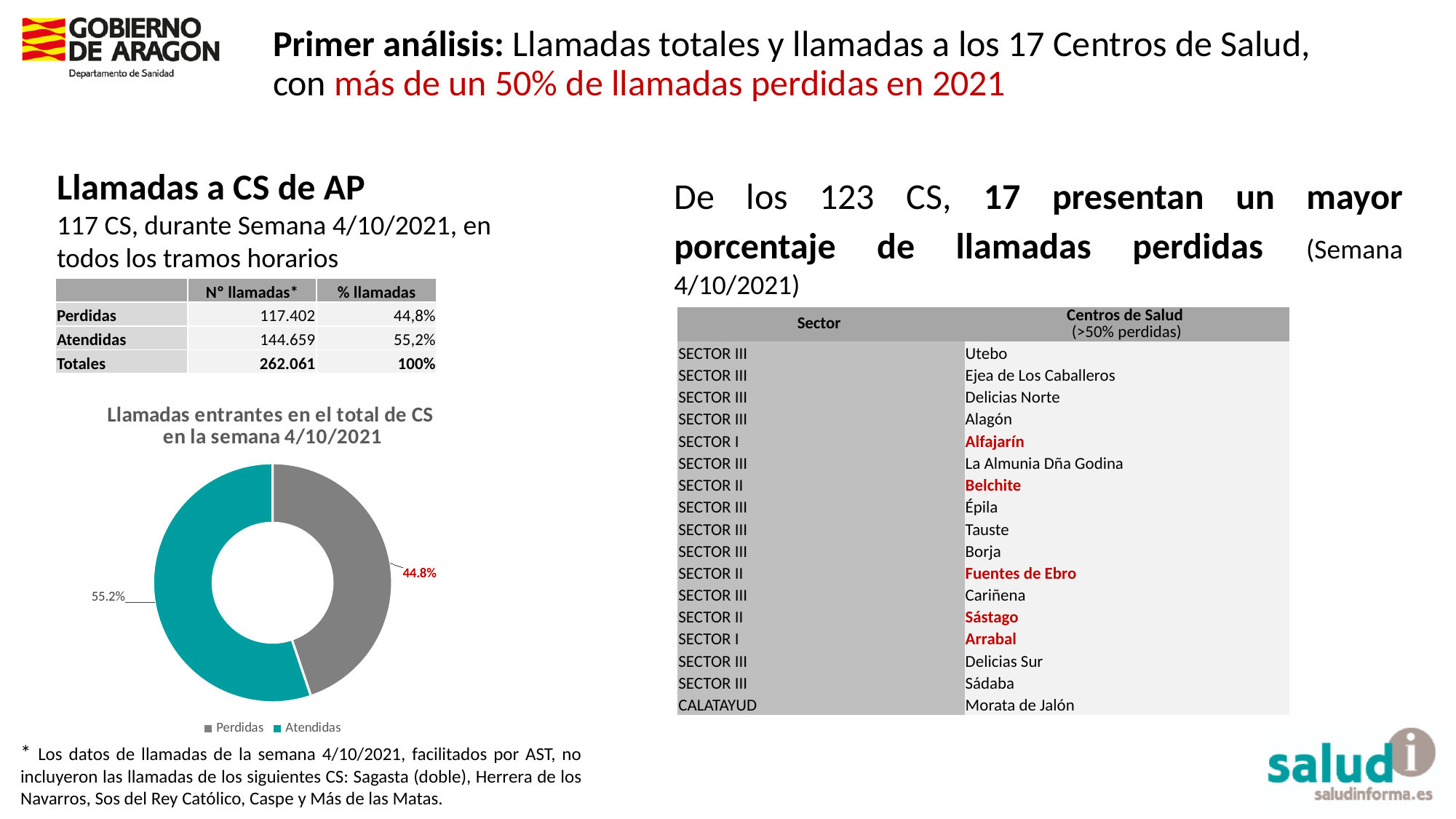
What colour is the Atendidas slice in the pie chart? teal What is the title of the chart? Llamadas entrantes en el total de CS en la semana 4/10/2021 What is the difference in percentage points between the Atendidas and Perdidas slices? 10.4 What do the two slices of the pie chart add up to? 100% What share of the pie chart does the Perdidas slice represent? 44.8% Which slice of the pie chart is the largest? Atendidas What share of the pie chart does the Atendidas slice represent? 55.2% What kind of chart is shown on the slide? doughnut chart How many entries does the chart legend list? 2 Which slice of the pie chart is the smallest? Perdidas How many slices does the pie chart have? 2 Which is larger in the pie chart, Perdidas or Atendidas? Atendidas